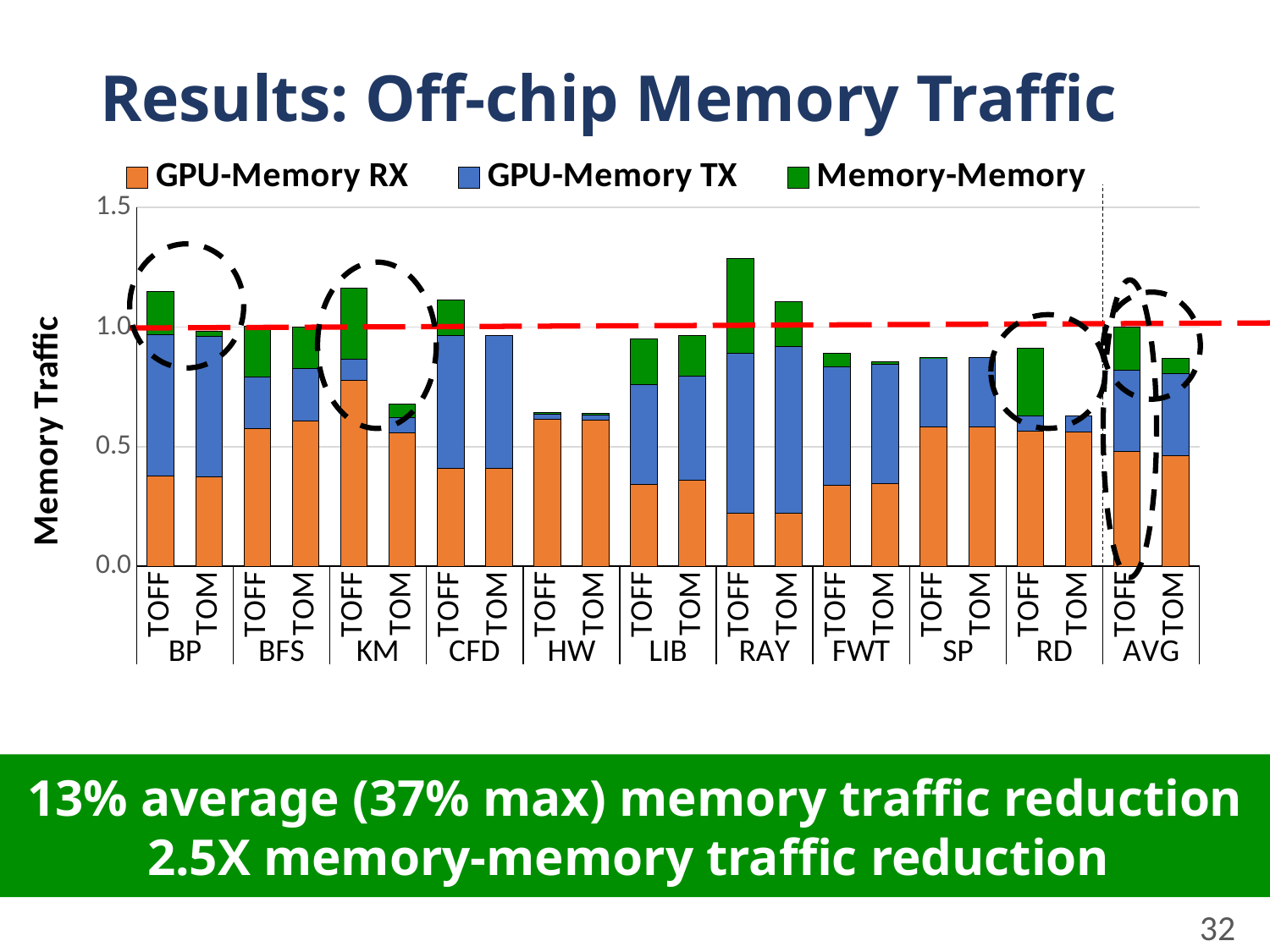
How many series does the legend list? 3 Is the total memory traffic for RAY TOFF greater or less than 1.0? greater What is the label of the y axis? Memory Traffic How many benchmark groups are shown along the x axis (including AVG)? 11 What are the three series named in the legend? GPU-Memory RX, GPU-Memory TX, Memory-Memory Is the total memory traffic for AVG TOM greater or less than 1.0? less Which has the larger total memory traffic, KM TOFF or KM TOM? KM TOFF Which bar has the highest total memory traffic? RAY TOFF Is the total memory traffic for KM TOM greater or less than 1.0? less How many bars are plotted in total on the chart? 22 What kind of chart is shown on the slide? Stacked bar chart